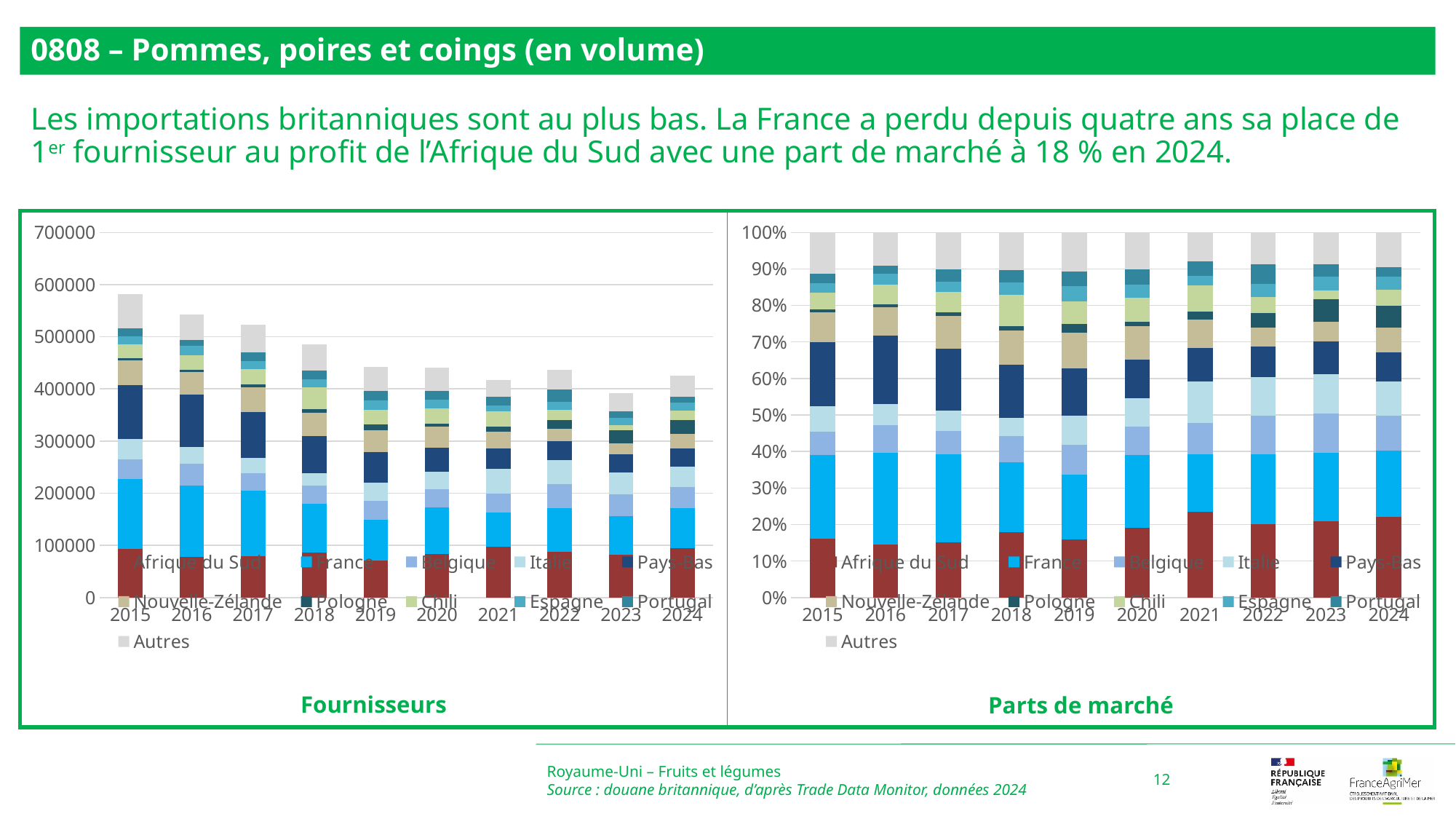
What is the title of the chart on the right side of the slide? Parts de marché In the 'Parts de marché' chart, is the share of France in 2015 greater or less than 20%? greater In the 'Fournisseurs' chart, which year has the lowest total bar? 2023 In the 'Parts de marché' chart, is the share of Afrique du Sud in 2015 greater or less than 20%? less In the 'Fournisseurs' chart, which year has the highest total bar? 2015 What kind of chart is the 'Fournisseurs' chart on the left? Stacked bar chart In the 'Fournisseurs' chart, is the total for 2023 greater or less than 450000? less In the 'Fournisseurs' chart, do the total bars rise or fall from 2015 to 2019? fall How many years are shown on the x axis of the 'Fournisseurs' chart? 10 In the 'Fournisseurs' chart, which total bar is larger, 2015 or 2024? 2015 How many series does the legend of the 'Parts de marché' chart list? 11